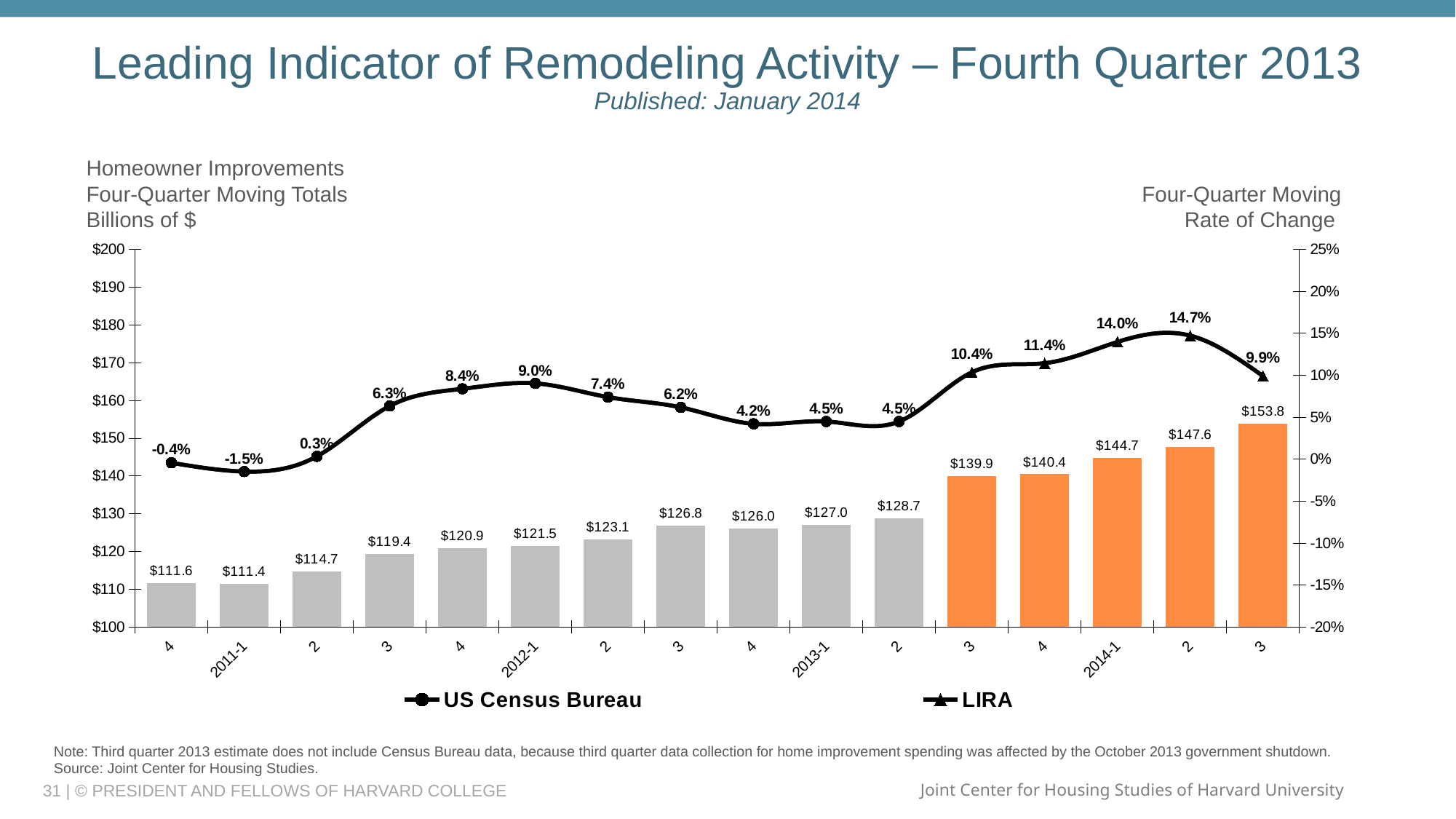
What four-quarter moving rate of change is labelled for 2014-1? 14.0% What is the difference between the four-quarter moving totals for 2014 Q3 and 2014 Q2? $6.2 Which quarter has the highest four-quarter moving total bar? 2014 Q3 ($153.8) What is the four-quarter moving total shown for 2013-1? $127.0 What is the four-quarter moving total (billions of $) shown for 2012-1? $121.5 Which quarter has the lowest four-quarter moving rate of change on the line? 2011-1 (-1.5%) What are the two series named in the legend? US Census Bureau and LIRA How many quarterly bars are plotted on the chart? 16 How many series does the legend list? 2 Which quarter has the highest four-quarter moving rate of change on the line? 2014 Q2 (14.7%) Which quarter has the lowest four-quarter moving total bar? 2011-1 ($111.4) Which is larger, the four-quarter moving total for 2012 Q3 or for 2012 Q4? 2012 Q3 ($126.8)